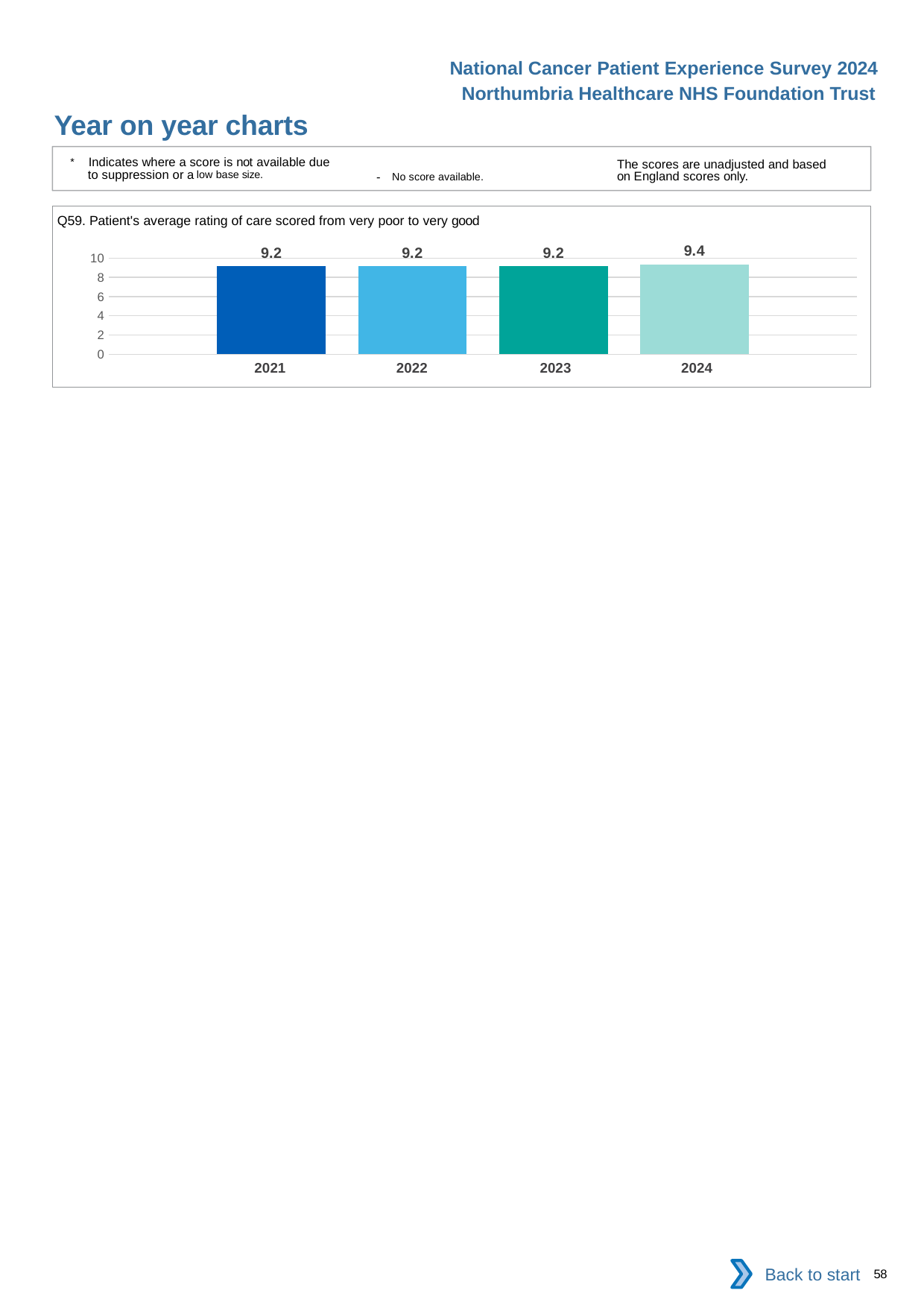
What is the value for 2023? 9.2 Which year has the highest value? 2024 Do the values rise or fall from 2023 to 2024? rise What kind of chart is shown? bar chart Which is larger, the value for 2022 or the value for 2024? 2024 What is the value for 2021? 9.2 How many years are shown on the chart? 4 What is the maximum value shown on the y axis? 10 What is the title of the chart? Q59. Patient's average rating of care scored from very poor to very good What is the difference between the values for 2024 and 2023? 0.2 Is the value for 2021 greater or less than 8? greater What is the value for 2024? 9.4